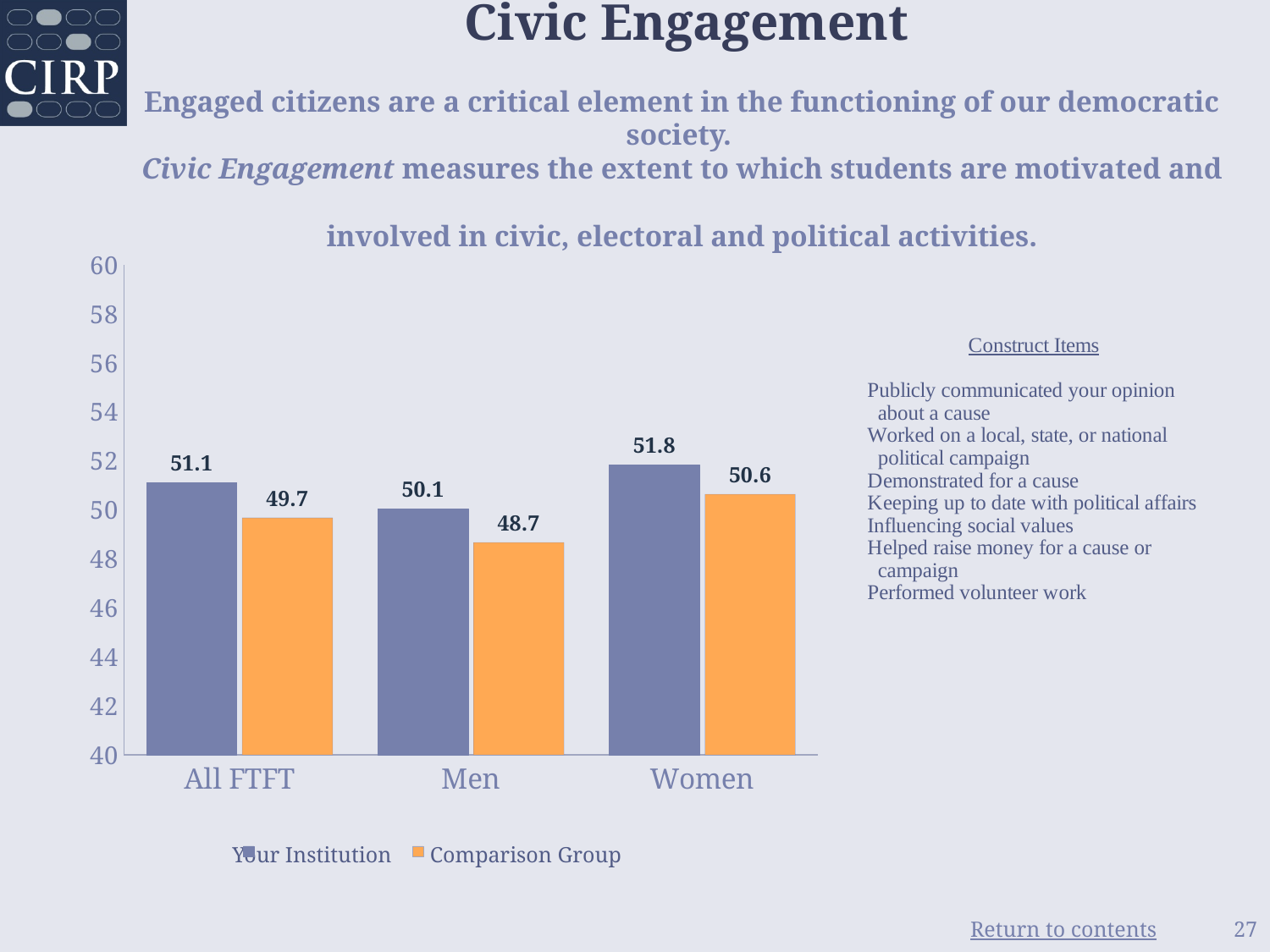
What is the Your Institution value for All FTFT? 51.1 Which category has the highest Your Institution value? Women What is the Comparison Group value for Men? 48.7 Which is larger for Men: the Your Institution value or the Comparison Group value? Your Institution Is the Comparison Group value for Women greater or less than 50? greater How many categories are shown on the x axis? 3 Which category has the lowest Comparison Group value? Men How many series does the legend list? 2 What kind of chart is shown on the slide? Bar chart What is the Your Institution value for Women? 51.8 What is the Comparison Group value for All FTFT? 49.7 What is the difference between the Your Institution and Comparison Group values for Women? 1.2